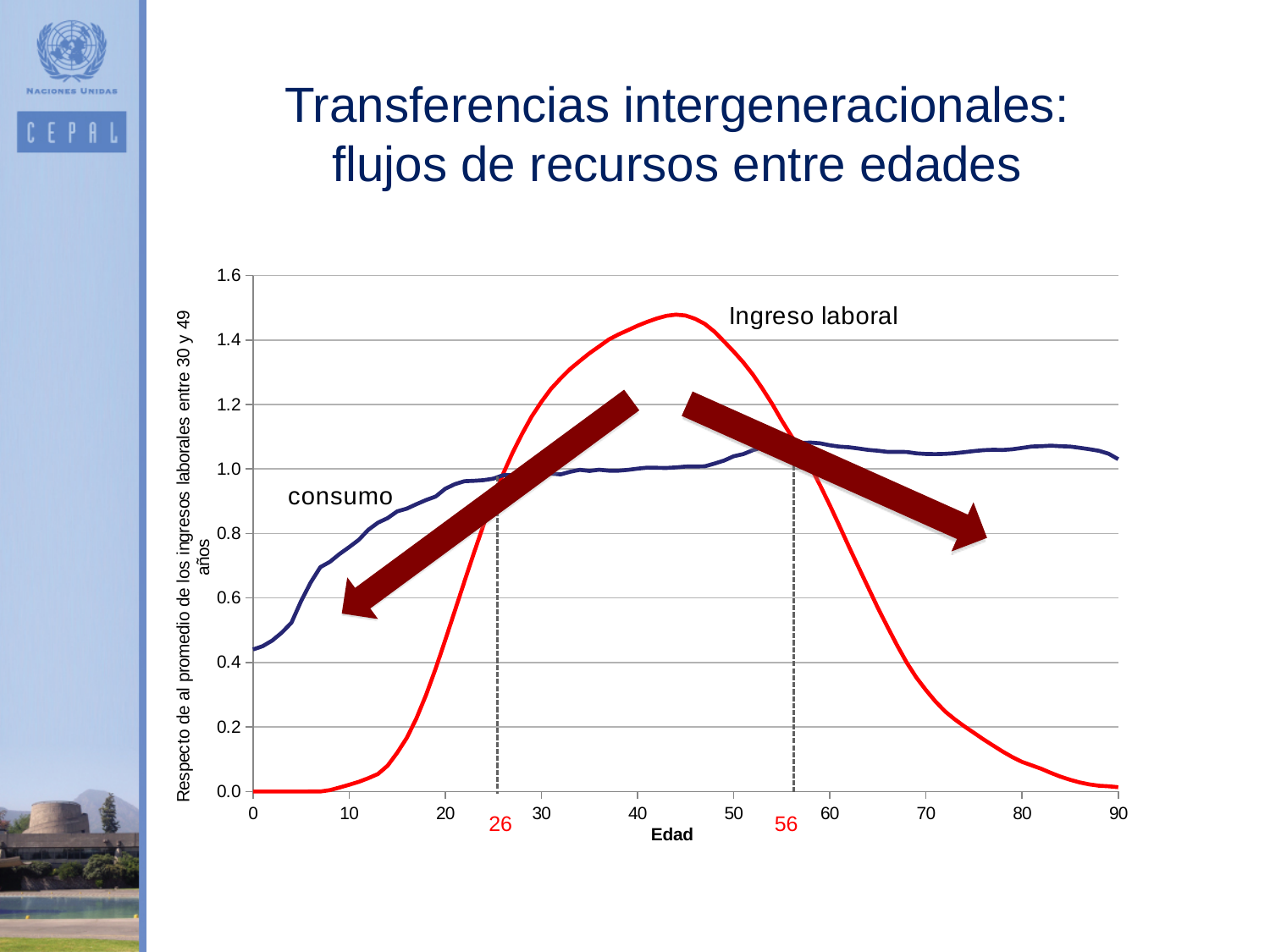
Is the value of Ingreso laboral at age 40 greater or less than 1.2? greater At age 40, which series has the higher value, consumo or Ingreso laboral? Ingreso laboral Does Ingreso laboral rise or fall between age 50 and age 90? fall Is the peak value of Ingreso laboral greater or less than 1.4? greater At age 10, which series has the higher value, consumo or Ingreso laboral? consumo What are the names of the two series plotted on the chart? consumo and Ingreso laboral What kind of chart is shown on the slide? line chart Does consumo rise or fall between age 0 and age 30? rise Is the value of Ingreso laboral at age 80 greater or less than 0.2? less What is the title of the x axis of the chart? Edad How many series are plotted on the chart? 2